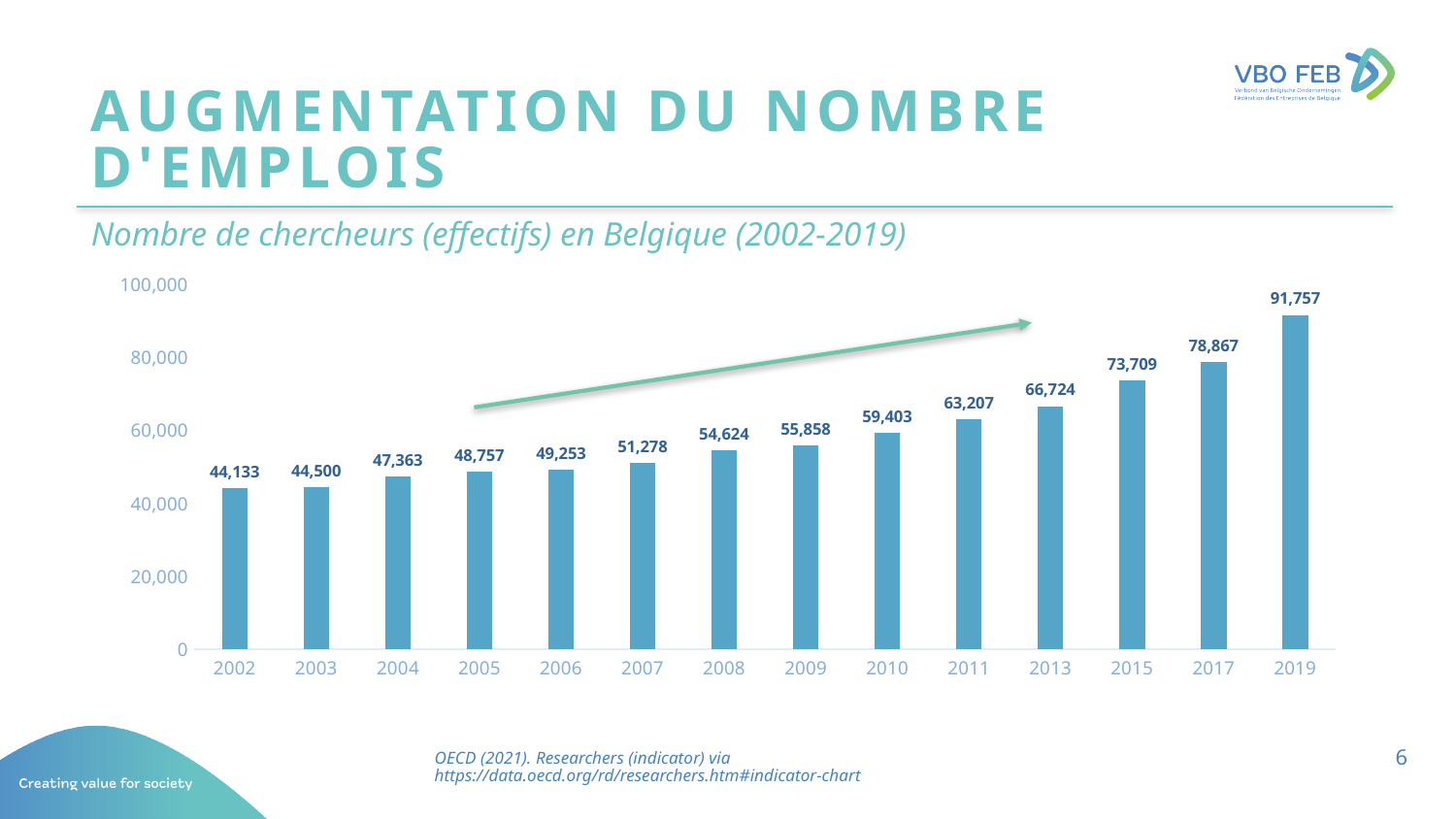
What value is shown for 2010? 59,403 What is the difference between the values for 2019 and 2002? 47,624 What value is shown for 2015? 73,709 What is the number of researchers in Belgium in 2019? 91,757 What is the number of researchers in Belgium in 2002? 44,133 Which is larger, the value for 2008 or the value for 2011? 2011 What kind of chart is shown on the slide? Bar chart Which year has the highest number of researchers? 2019 What is the difference between the values for 2017 and 2015? 5,158 How many years (bars) are shown on the chart? 14 Do the values rise or fall from 2002 to 2019? Rise Which year has the lowest number of researchers? 2002